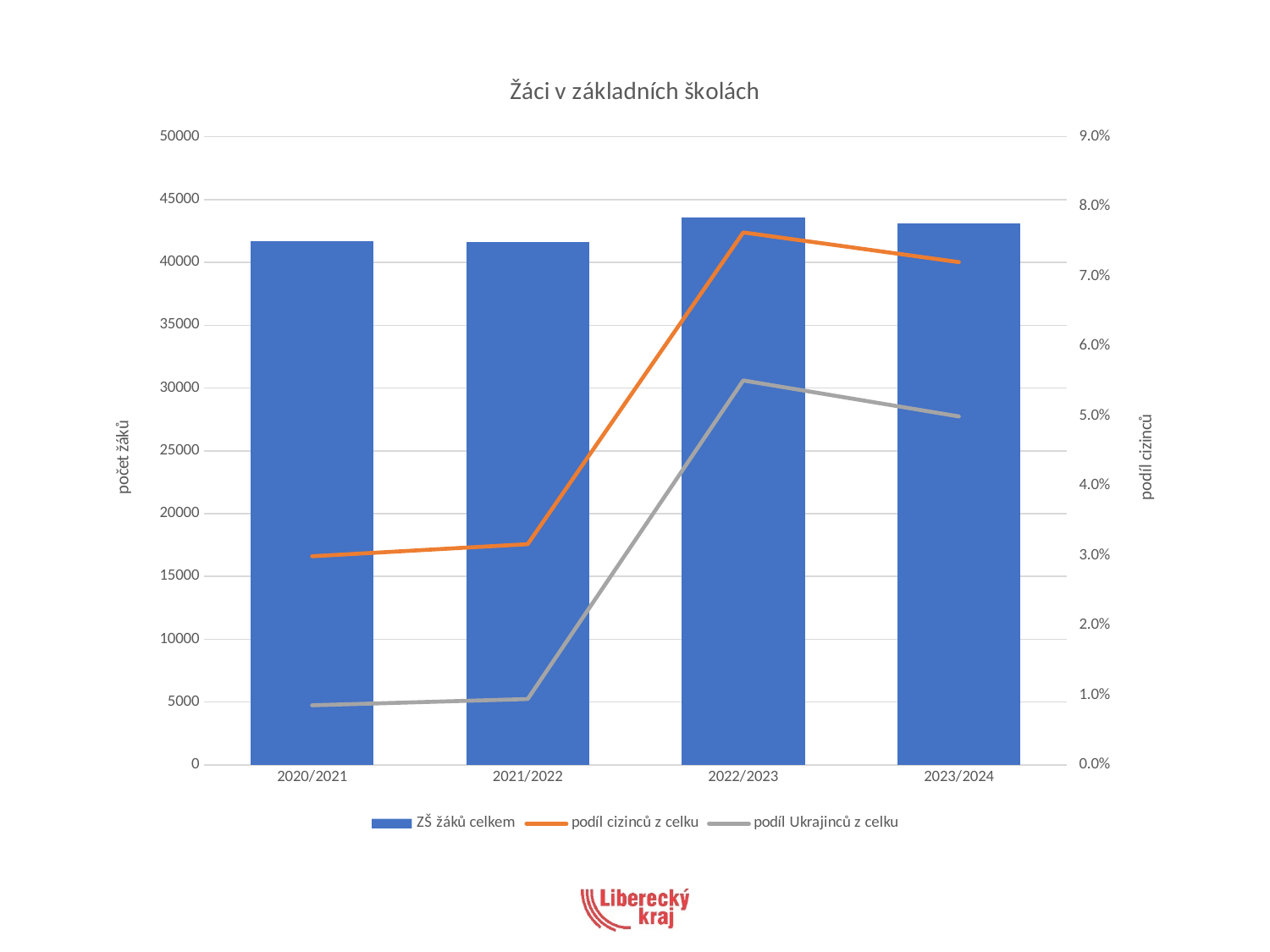
Is the value of ZŠ žáků celkem for 2022/2023 greater or less than 40000? greater Is the value of podíl Ukrajinců z celku for 2020/2021 greater or less than 2.0%? less In which school year is the bar for ZŠ žáků celkem highest? 2022/2023 How many school years are shown on the x axis? 4 Which series is drawn as bars? ZŠ žáků celkem In which school year does the line podíl cizinců z celku reach its highest value? 2022/2023 How many series does the legend list? 3 In 2022/2023, which is larger: podíl cizinců z celku or podíl Ukrajinců z celku? podíl cizinců z celku Is the value of podíl cizinců z celku for 2020/2021 greater or less than 4.0%? less What kind of chart is shown on the slide? A combined bar and line chart Does the line podíl Ukrajinců z celku rise or fall from 2021/2022 to 2022/2023? rise What is the title of the chart? Žáci v základních školách